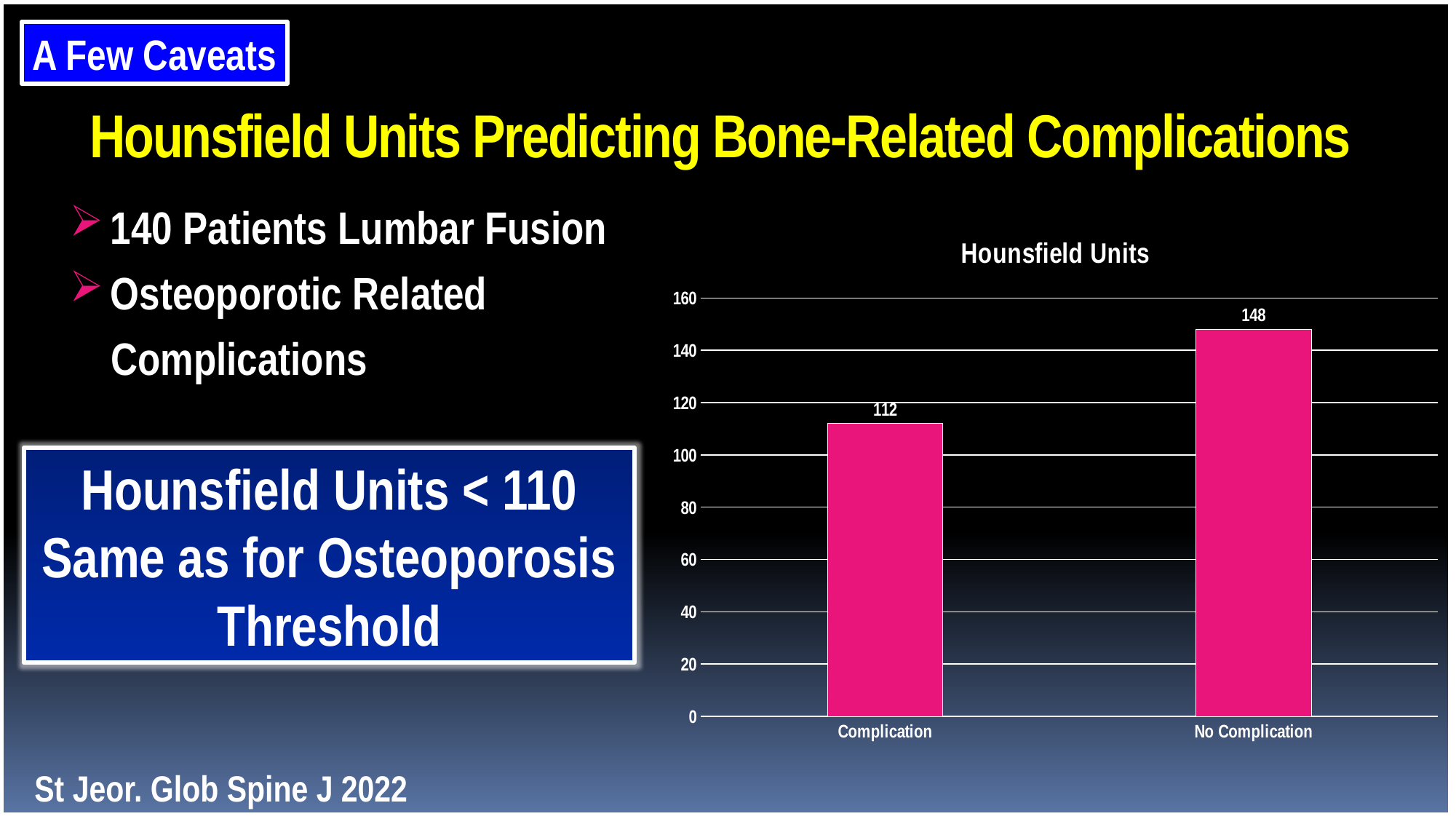
Is the value for Complication greater or less than 120? less What is the Hounsfield Units value for the Complication group? 112 What is the maximum value shown on the chart's y axis? 160 Which category has the lower Hounsfield Units value? Complication What is the title of the chart? Hounsfield Units What kind of chart is shown on the slide? bar chart Which category has the higher Hounsfield Units value? No Complication How many categories are shown on the x axis of the chart? 2 What is the Hounsfield Units value for the No Complication group? 148 What is the difference in Hounsfield Units between the No Complication and Complication groups? 36 Is the Hounsfield Units value for Complication larger or smaller than that for No Complication? smaller Is the value for No Complication greater or less than 140? greater